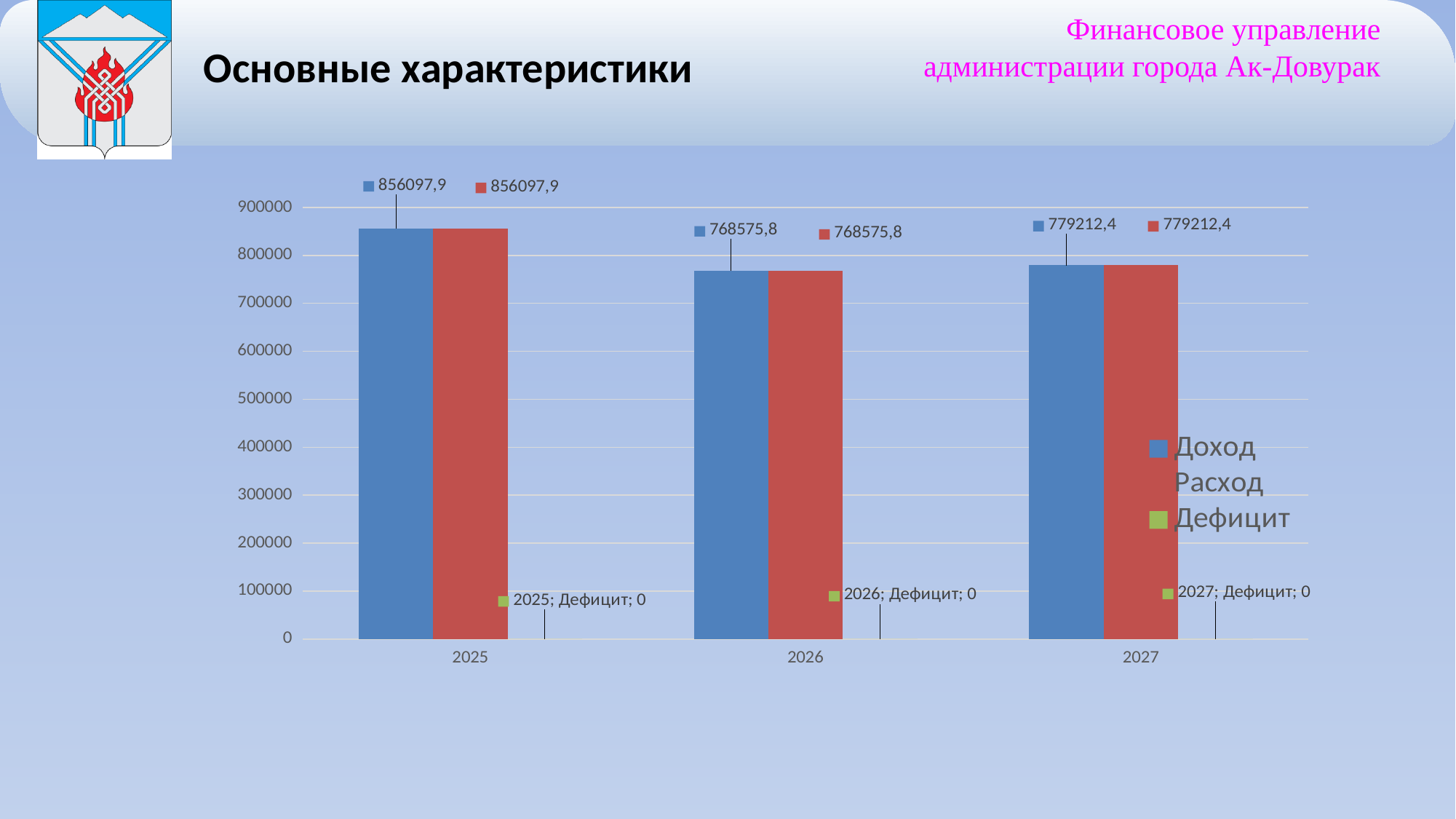
What kind of chart is shown on the slide? bar chart Is Доход for 2027 greater or less than 800000? less What is the value of Расход for 2026? 768575,8 In which year is Доход the highest? 2025 What is the difference between Доход in 2025 and Доход in 2026? 87522,1 In which year is Расход the lowest? 2026 What is the value of Доход for 2027? 779212,4 Which colour represents Дефицит in the legend? green How many series does the legend list? 3 How many years are shown on the x axis? 3 What is the value of Доход for 2025? 856097,9 What is the value of Дефицит for 2026? 0